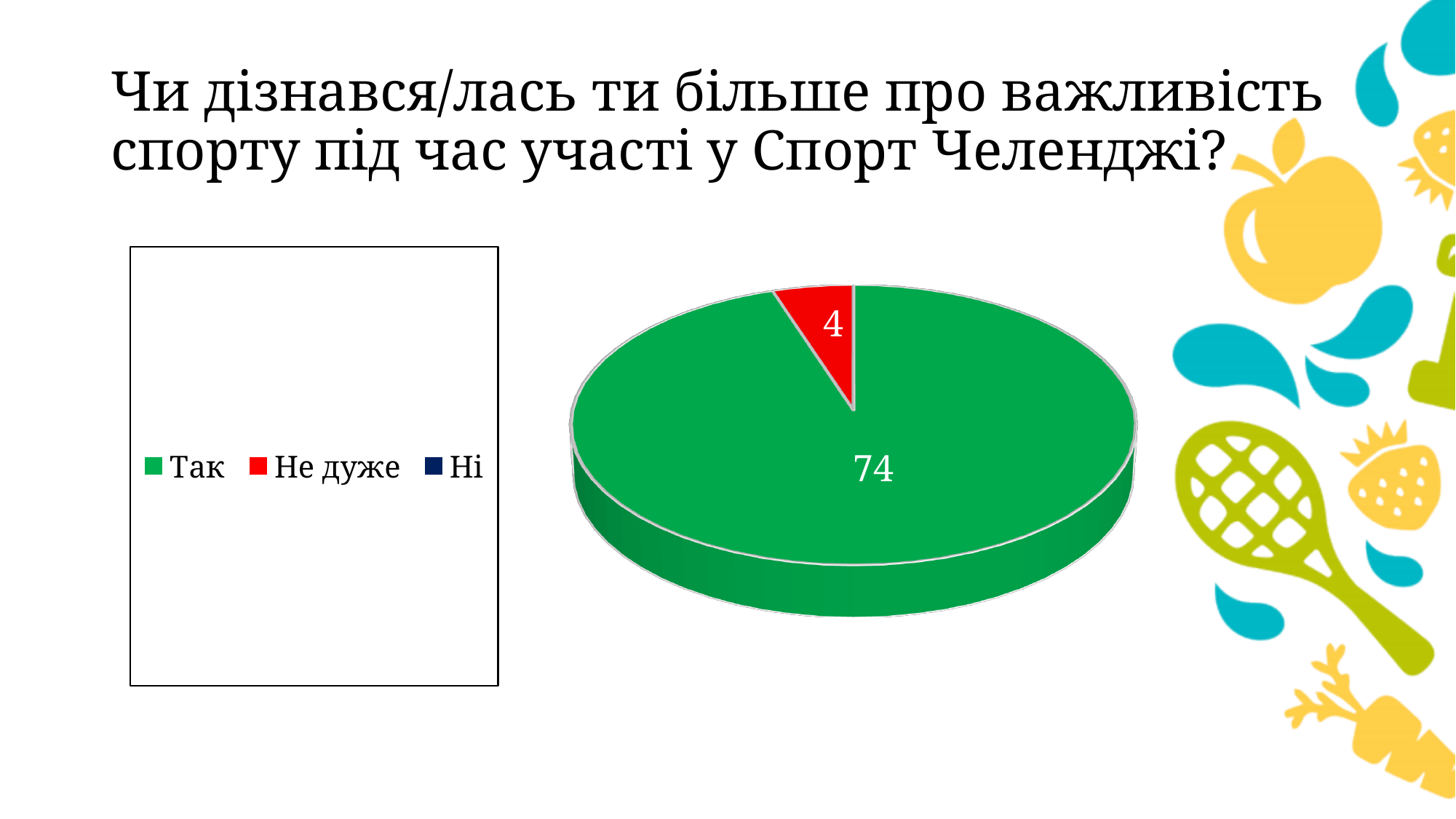
What kind of chart is shown on the slide? Pie chart What colour is the "Так" slice in the pie chart? Green What value is shown for the "Не дуже" slice of the pie chart? 4 How many categories does the legend of the pie chart list? 3 What is the difference between the values for "Так" and "Не дуже"? 70 How many slices have a data label printed on the pie chart? 2 Which is larger, the value for "Так" or the value for "Не дуже"? Так Which legend entry is shown in red? Не дуже Which category has the largest slice in the pie chart? Так What value is shown for the "Так" slice of the pie chart? 74